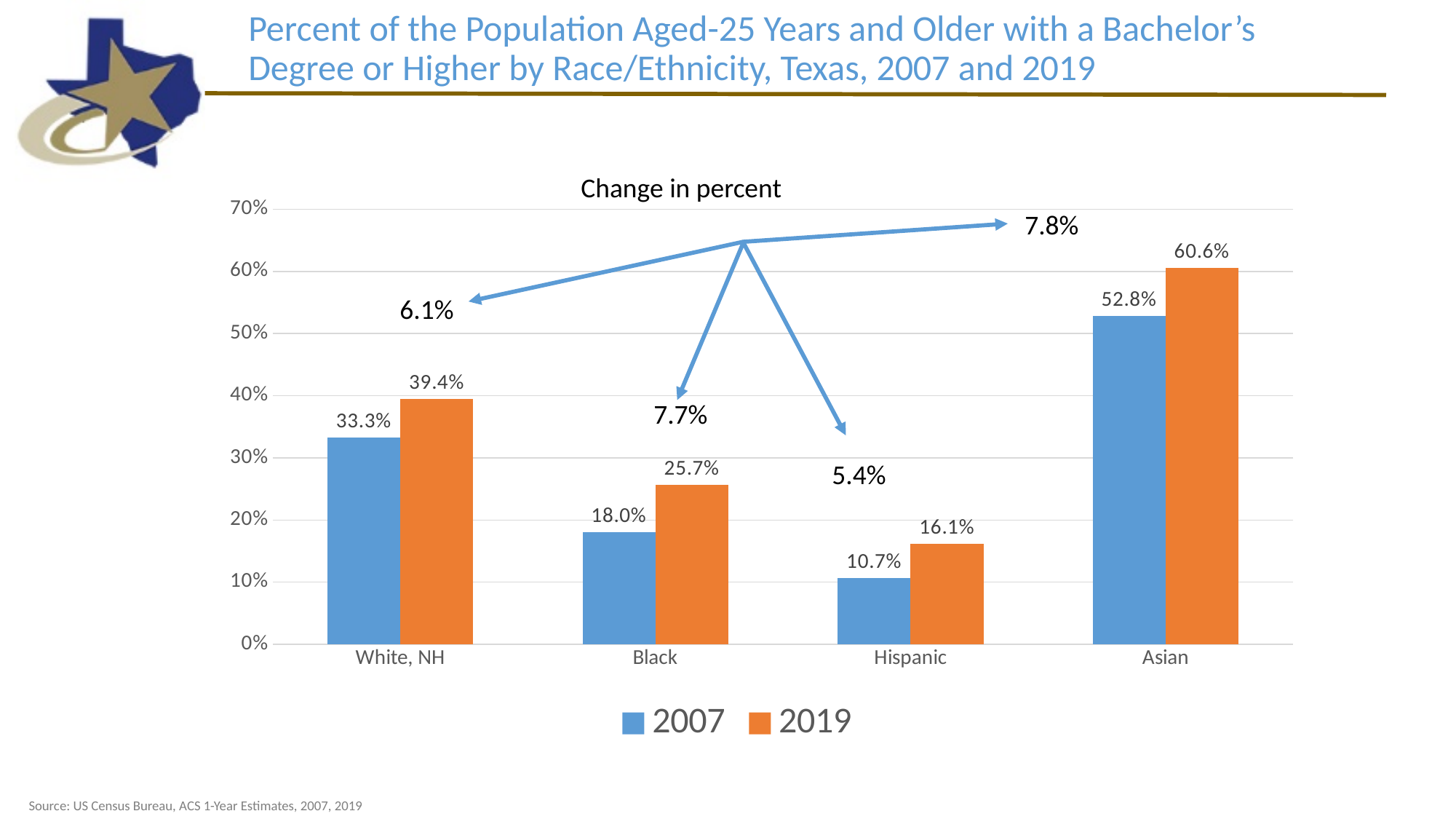
Which is larger: the 2007 value for Black or the 2019 value for Hispanic? 2007 value for Black What was the percent of the population aged 25 and older with a bachelor's degree or higher for Hispanic Texans in 2007? 10.7% What was the 2019 value for Black Texans? 25.7% What is the difference between the 2019 and 2007 values for White, NH? 6.1% Which race/ethnicity group had the lowest percent with a bachelor's degree or higher in 2007? Hispanic How many series does the legend list? 2 How many race/ethnicity categories are shown on the x axis? 4 Which group had the largest change in percent between 2007 and 2019, according to the annotations? Asian What kind of chart is shown on the slide? Bar chart What is the difference between the 2019 values for Asian and White, NH? 21.2% What was the 2019 value for Asian Texans? 60.6% Which race/ethnicity group had the highest percent with a bachelor's degree or higher in 2019? Asian